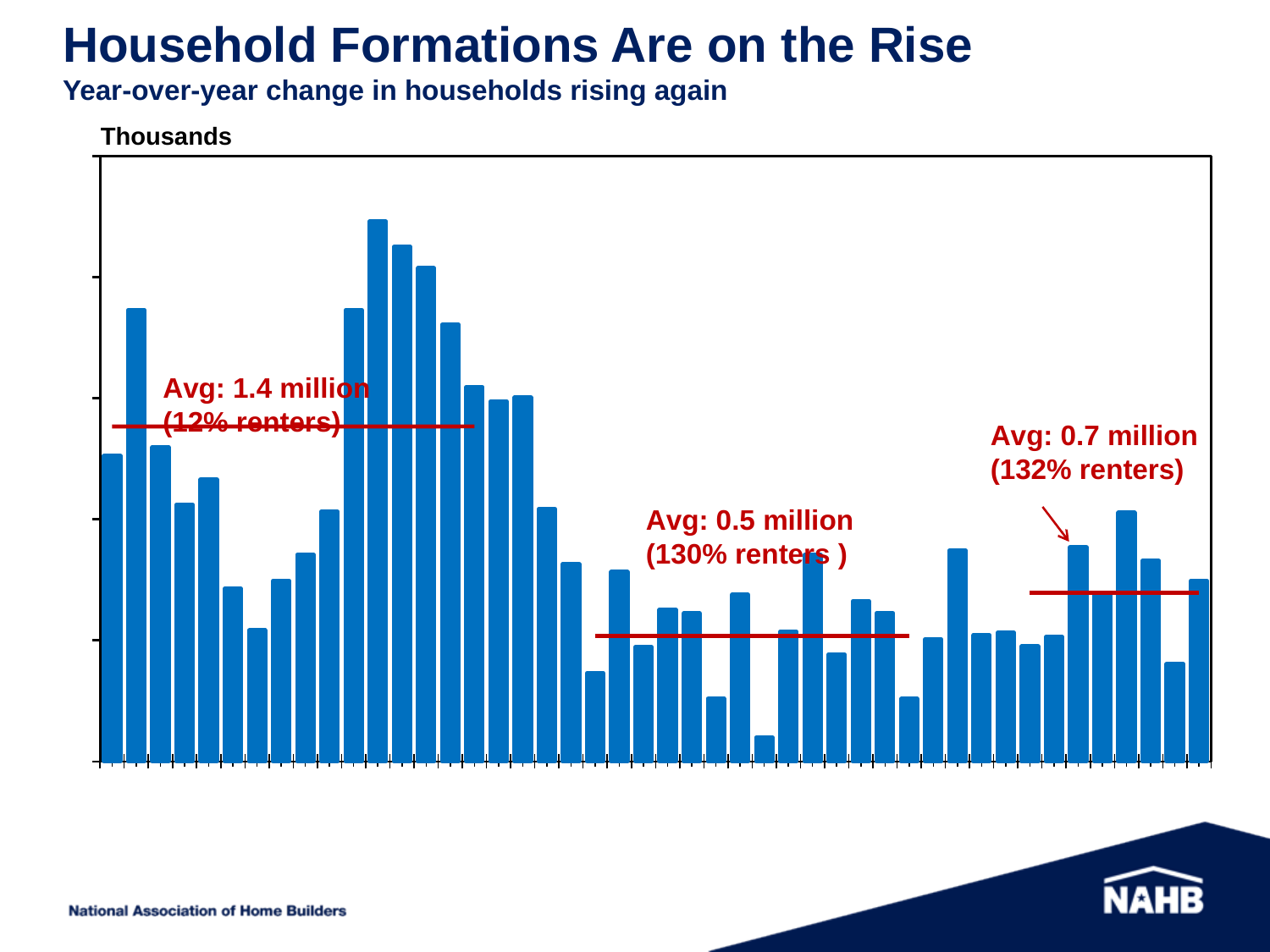
Which of the three annotated period averages is the highest? 1.4 million What is the difference between the 1.4 million average and the 0.7 million average? 0.7 million What average is annotated for the earliest period on the chart? 1.4 million What unit label is shown above the vertical axis of the chart? Thousands What renter share is annotated alongside the 0.7 million average? 132% renters What kind of chart is shown on the slide? bar chart Is the tallest bar on the chart located in the left half or the right half of the chart? left half Which is larger, the average annotated for the middle period or the average annotated for the latest period? the latest period (0.7 million) What is the title of the slide's chart? Household Formations Are on the Rise What renter share is annotated alongside the 0.5 million average? 130% renters Which of the three annotated period averages is the lowest? 0.5 million Moving right from the tallest bar on the chart, do the next several bars rise or fall? fall